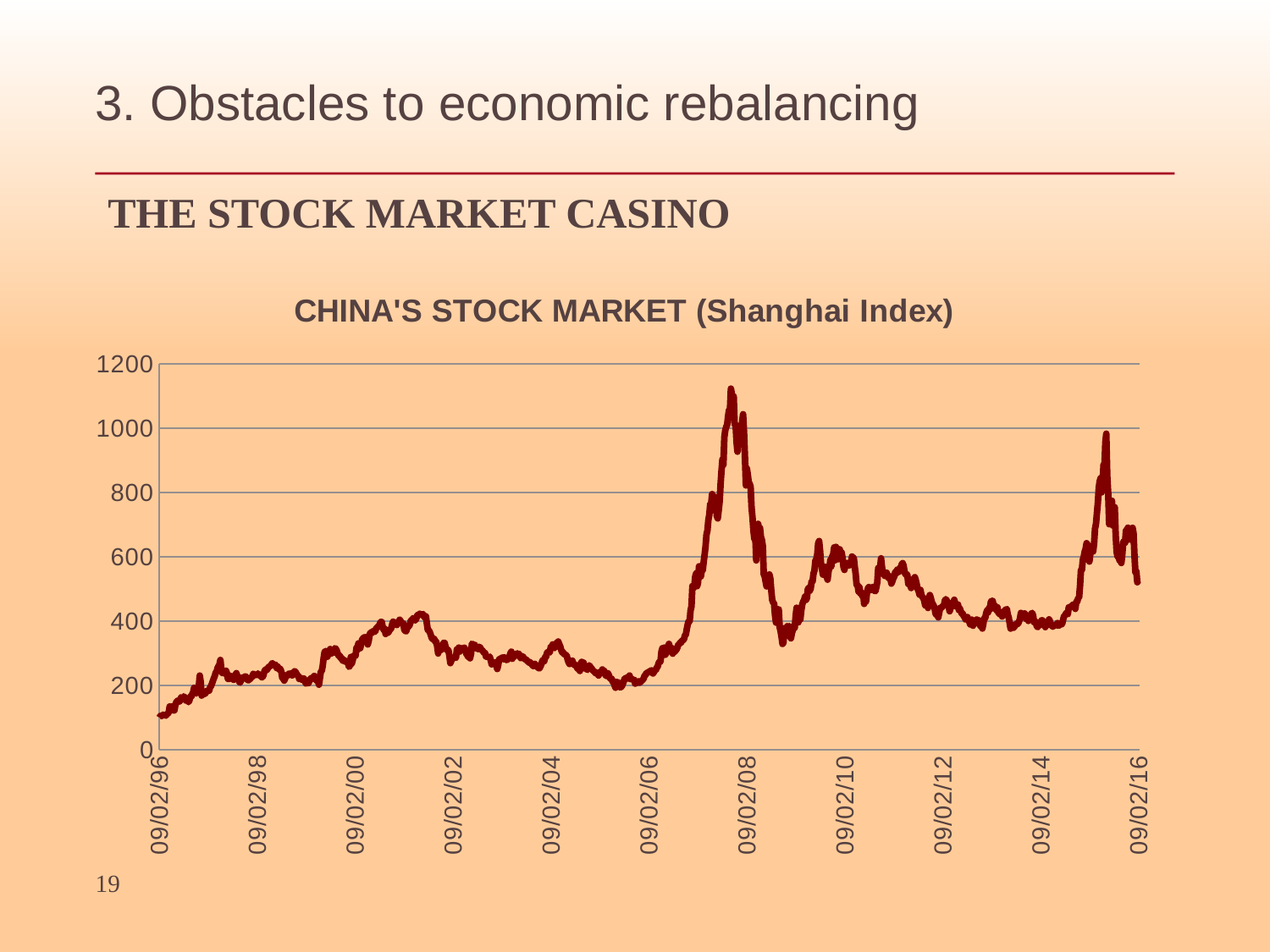
What is the title of the chart? CHINA'S STOCK MARKET (Shanghai Index) Is the value of the Shanghai Index at 09/02/06 greater or less than 400? less Between which two x-axis labels does the Shanghai Index reach its highest peak? 09/02/06 and 09/02/08 Is the value of the Shanghai Index at 09/02/16 greater or less than 400? greater Is the highest peak of the Shanghai Index on the chart greater or less than 1000? greater What kind of chart is shown on the slide? line chart What is the highest value shown on the vertical axis of the chart? 1200 Does the Shanghai Index rise or fall overall between 09/02/08 and 09/02/10? fall How many date labels are shown along the x axis of the chart? 11 Does the Shanghai Index rise or fall between 09/02/96 and 09/02/98? rise